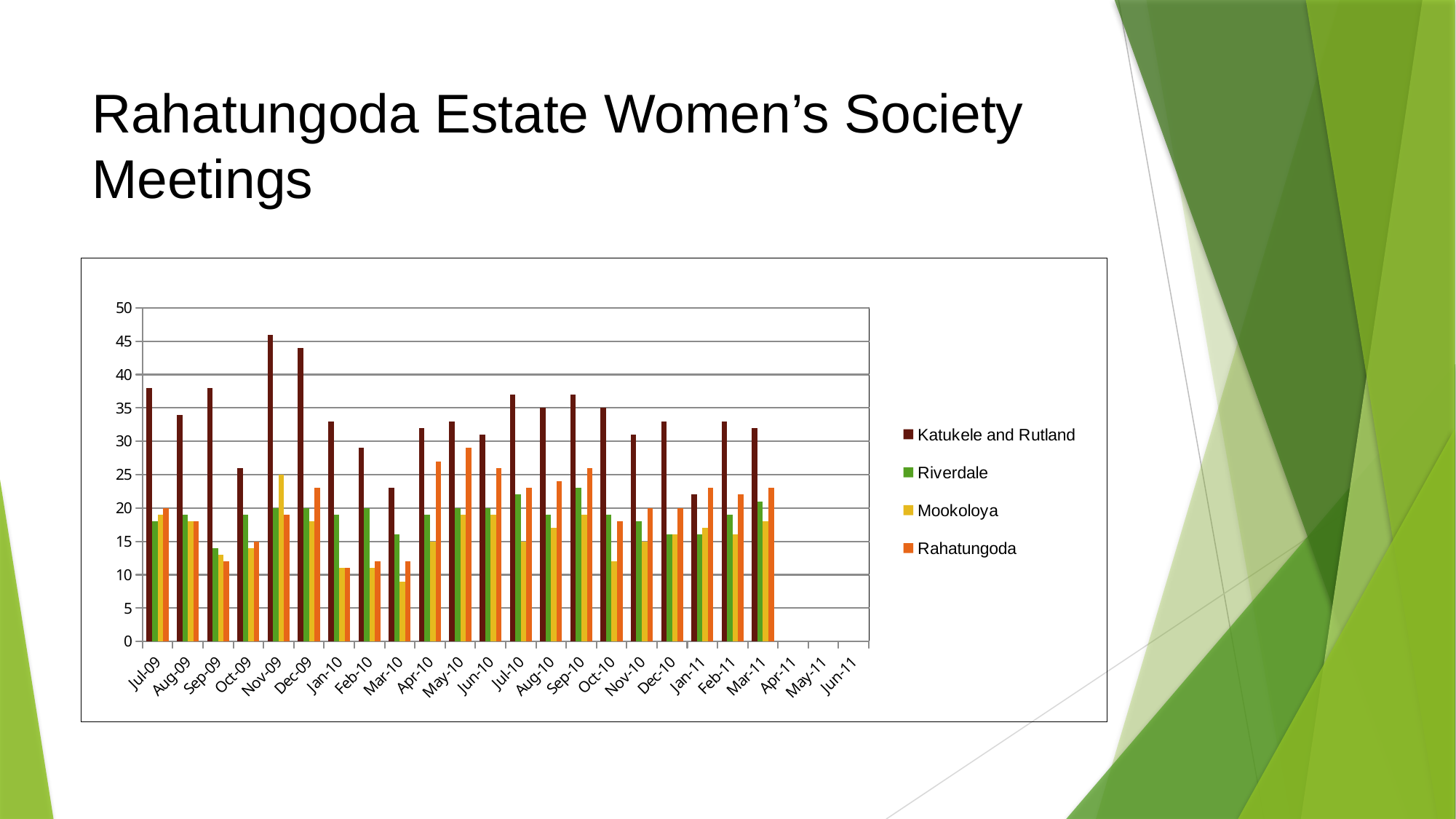
Which series is shown in dark brown in the legend? Katukele and Rutland How many month categories are labelled on the x axis? 24 Which is larger, the value for Katukele and Rutland in Jul-09 or in Aug-09? Jul-09 Is the value for Mookoloya in Mar-10 greater or less than 15? less Is the value for Rahatungoda in Jul-09 greater or less than 25? less How many series does the legend list? 4 In Apr-10, which is larger, the value for Rahatungoda or for Mookoloya? Rahatungoda Is the value for Katukele and Rutland in Dec-09 greater or less than 40? greater In which month is the value for Katukele and Rutland highest? Nov-09 What kind of chart is shown on the slide? bar chart In which month is the value for Mookoloya highest? Nov-09